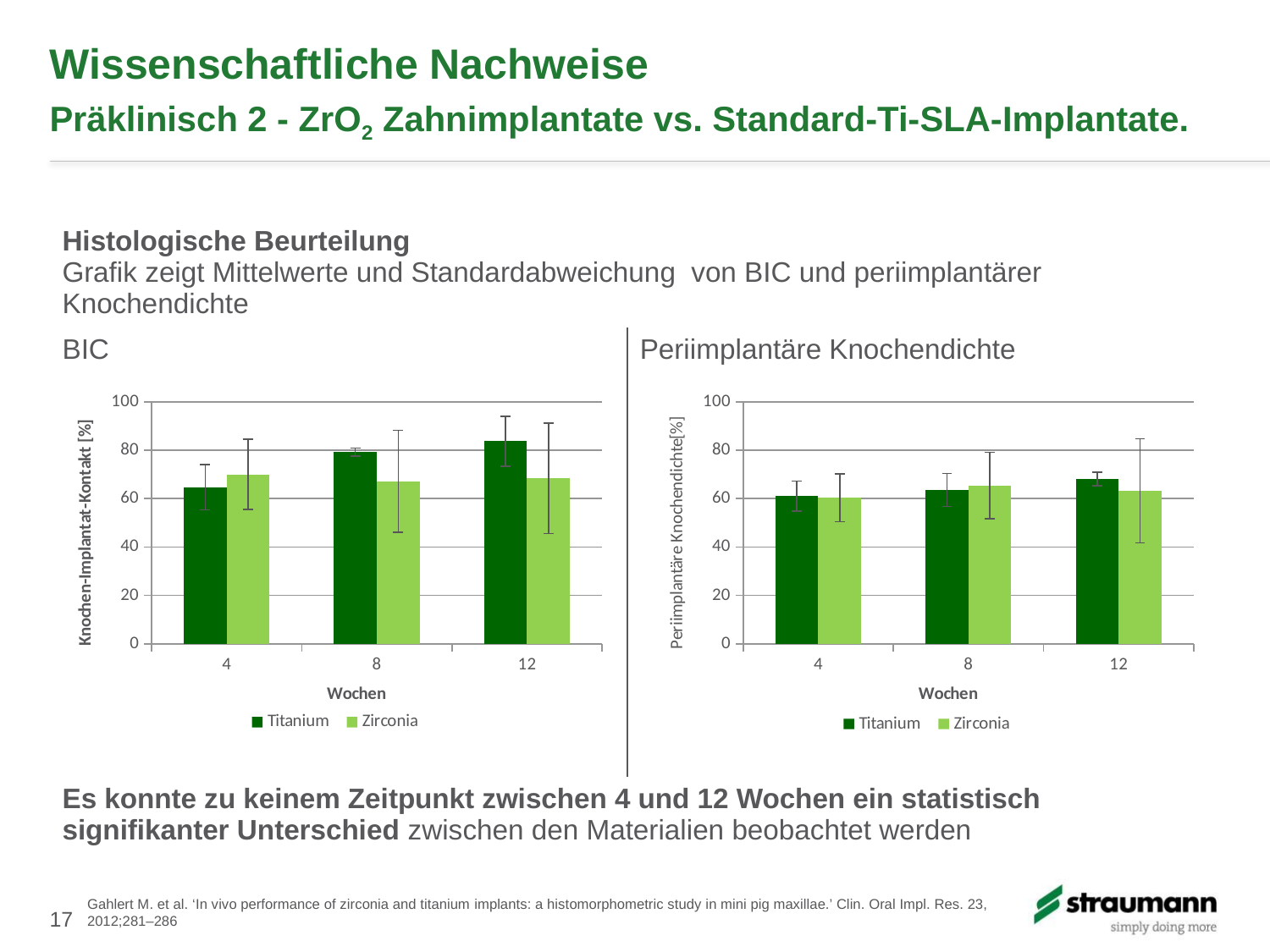
In the BIC chart, is the Titanium value at 4 weeks greater or less than 80? less In the BIC chart, is the Titanium value at 12 weeks greater or less than 80? greater In the BIC chart, do the Titanium values rise or fall from 4 to 12 weeks? rise In the Periimplantäre Knochendichte chart, what is the x axis title? Wochen In the BIC chart, at 8 weeks, which series has the larger value, Titanium or Zirconia? Titanium In the Periimplantäre Knochendichte chart, is the Titanium value at 12 weeks greater or less than 60? greater In the BIC chart, how many series does the legend list? 2 In the BIC chart, what kind of chart is shown? bar chart In the Periimplantäre Knochendichte chart, how many week categories are shown on the x axis? 3 In the BIC chart, at which week is the Titanium value highest? 12 In the BIC chart, at 12 weeks, which series has the larger value, Titanium or Zirconia? Titanium